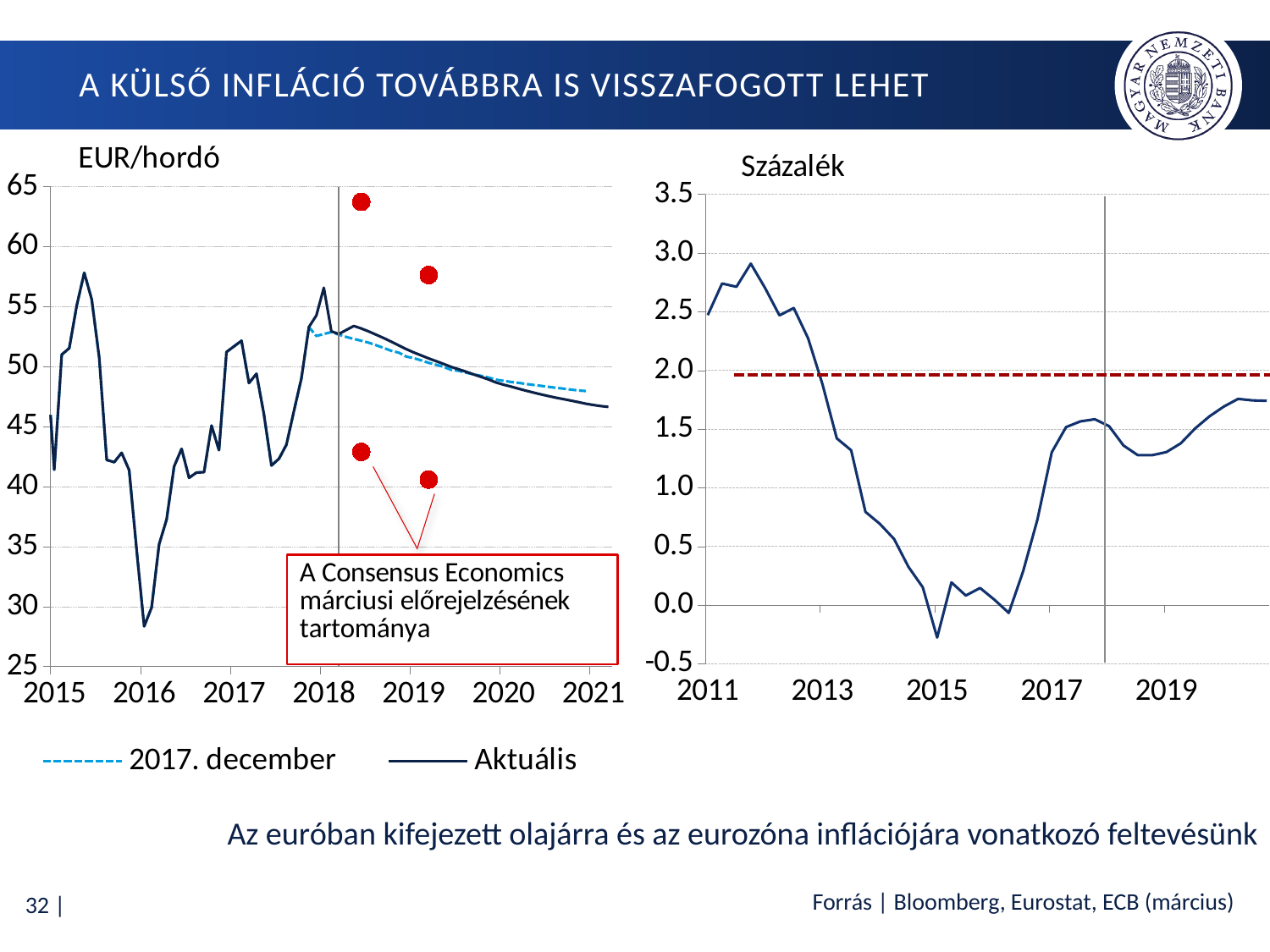
In the left chart (EUR/hordó), is the Aktuális line at 2021 greater or less than 50? less In the left chart (EUR/hordó), does the Aktuális line rise or fall between 2018 and 2021? fall In the right chart (Százalék), is the peak value around 2011–2012 greater or less than 2.5? greater What kind of chart is the right chart (Százalék)? line chart In the left chart (EUR/hordó), is the highest red dot greater or less than 60? greater In the right chart (Százalék), does the line rise or fall from 2012 to 2015? fall What kind of chart is the left chart (EUR/hordó)? line chart How many series does the legend below the left chart (EUR/hordó) list? 2 In the left chart (EUR/hordó), what are the two legend entries? 2017. december; Aktuális